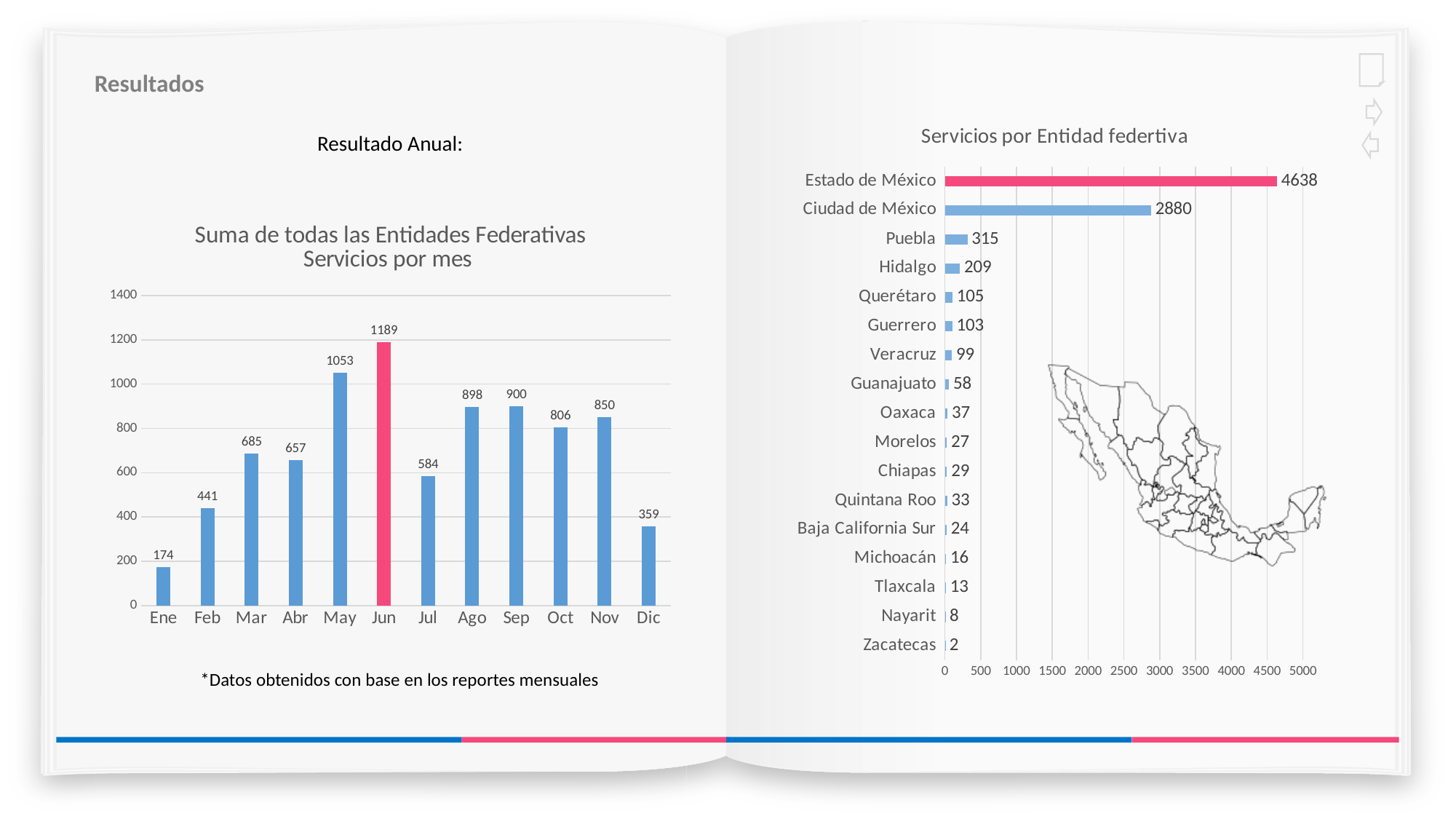
In the 'Suma de todas las Entidades Federativas Servicios por mes' chart, what is the value for May? 1053 In the 'Servicios por Entidad federtiva' chart, what is the value for Puebla? 315 In the 'Suma de todas las Entidades Federativas Servicios por mes' chart, how many months are plotted? 12 What kind of chart is 'Suma de todas las Entidades Federativas Servicios por mes'? Bar chart In the 'Suma de todas las Entidades Federativas Servicios por mes' chart, which month has the lowest value? Ene In the 'Servicios por Entidad federtiva' chart, which entity has the highest value? Estado de México In the 'Suma de todas las Entidades Federativas Servicios por mes' chart, which is larger, the value for Oct or the value for Nov? Nov In the 'Suma de todas las Entidades Federativas Servicios por mes' chart, which month has the highest value? Jun In the 'Servicios por Entidad federtiva' chart, which entity has the lowest value? Zacatecas In the 'Suma de todas las Entidades Federativas Servicios por mes' chart, what is the difference between the values for Jun and Jul? 605 In the 'Servicios por Entidad federtiva' chart, what is the difference between the values for Estado de México and Ciudad de México? 1758 In the 'Servicios por Entidad federtiva' chart, how many entities are plotted? 17